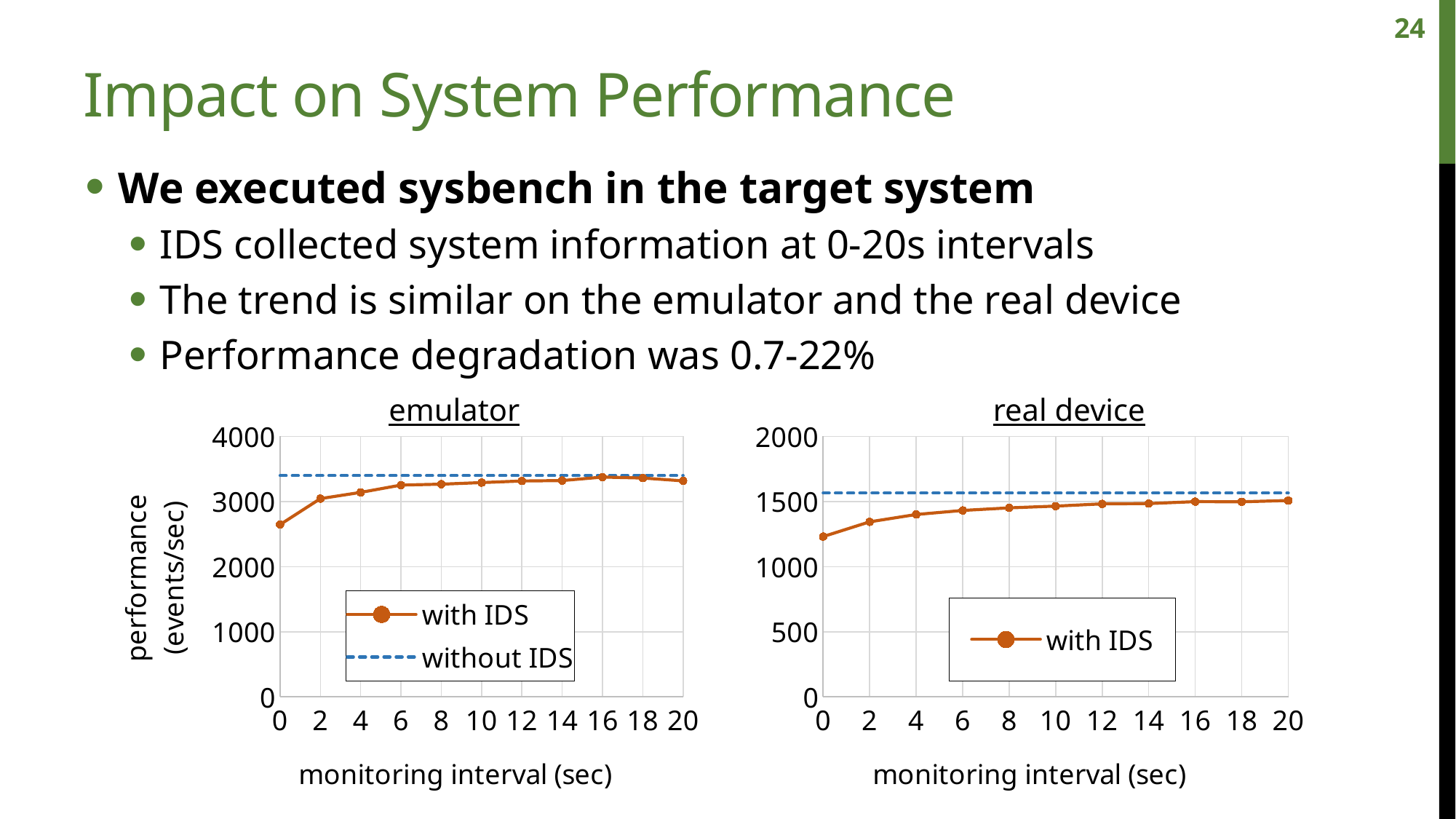
In the real device chart, at which monitoring interval is the 'with IDS' performance lowest? 0 In the real device chart, is the 'with IDS' value at a monitoring interval of 0 seconds greater or less than 1500? less In the real device chart, does the 'with IDS' performance rise or fall as the monitoring interval increases? rise In the emulator chart, what kind of chart is shown? line chart In the emulator chart, how many series does the legend list? 2 What is the x-axis label of the real device chart? monitoring interval (sec) In the emulator chart, is the 'with IDS' value at a monitoring interval of 0 seconds greater or less than 3000? less In the emulator chart, is the 'with IDS' value at a monitoring interval of 20 seconds greater or less than 3000? greater In the emulator chart, which is larger: the 'with IDS' value at 0 seconds or at 20 seconds? 20 seconds In the real device chart, how many series does the legend list? 1 In the emulator chart, how many data points are plotted for the 'with IDS' series? 11 In the emulator chart, does the 'with IDS' performance rise or fall as the monitoring interval increases from 0 to 6 seconds? rise